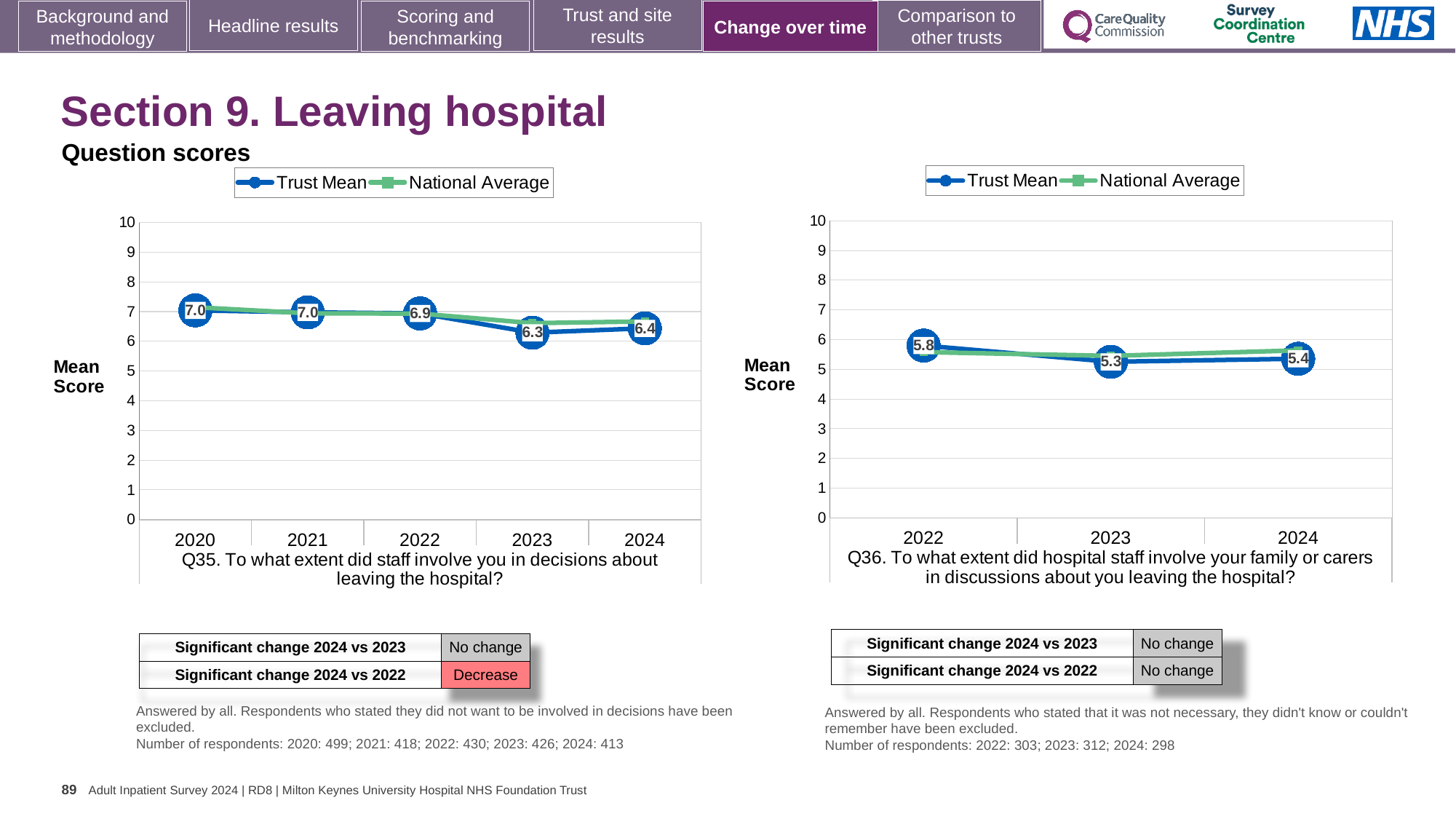
In the Q35 chart (left), how many years are plotted on the x axis? 5 In the Q35 chart (left), what is the difference between the Trust Mean in 2020 and in 2024? 0.6 In the Q35 chart (left), what is the Trust Mean for 2020? 7.0 In the Q36 chart (right), what is the Trust Mean for 2023? 5.3 What kind of chart is the Q35 chart (left)? Line chart In the Q36 chart (right), is the Trust Mean for 2022 greater or less than 5? greater In the Q35 chart (left), which year has the lowest Trust Mean? 2023 In the Q36 chart (right), what is the Trust Mean for 2022? 5.8 In the Q36 chart (right), how many series does the legend list? 2 In the Q36 chart (right), which year has the highest Trust Mean? 2022 In the Q35 chart (left), what is the Trust Mean for 2024? 6.4 In the Q35 chart (left), what is the Trust Mean for 2023? 6.3